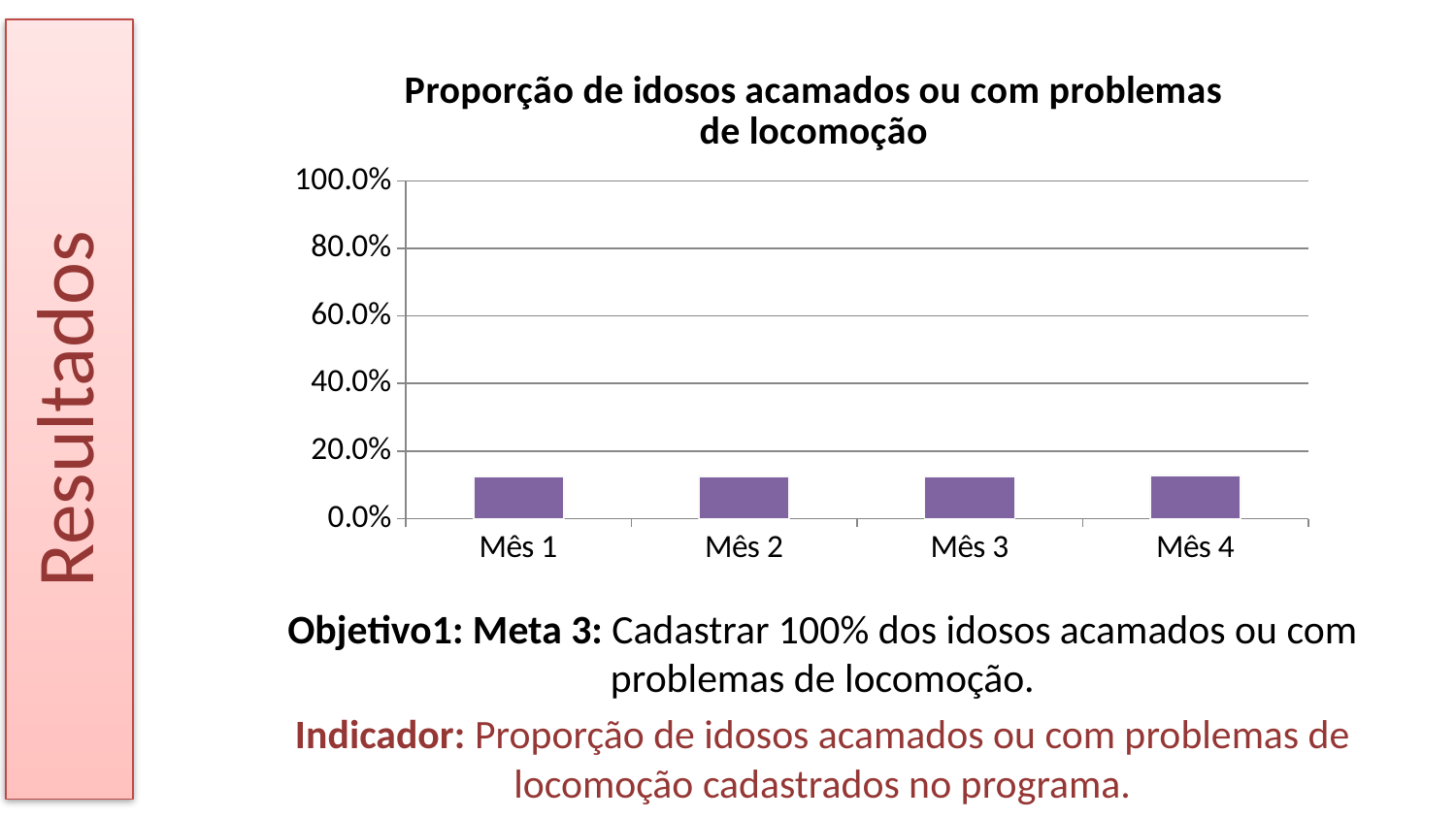
Is the value for Mês 2 greater or less than 20.0%? less Do the values rise, fall, or stay roughly constant from Mês 1 to Mês 4? stay roughly constant What is the highest value shown on the chart's y axis? 100.0% Is the value for Mês 4 greater or less than 20.0%? less Is the value for Mês 3 greater or less than 40.0%? less What is the label of the first category on the x axis? Mês 1 What is the title of the chart? Proporção de idosos acamados ou com problemas de locomoção What kind of chart is shown on the slide? bar chart How many categories are shown on the x axis of the chart? 4 What is the label of the last category on the x axis? Mês 4